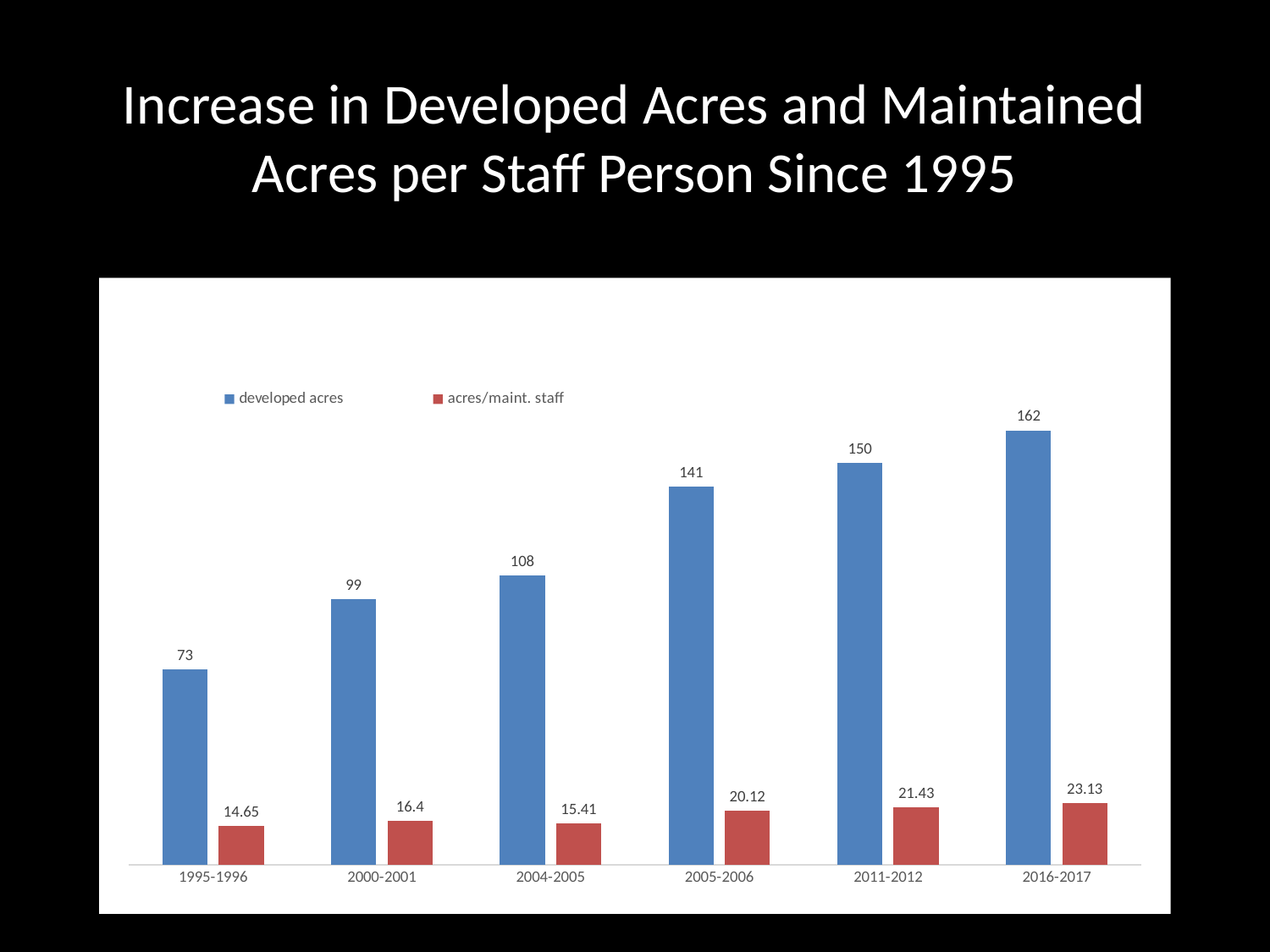
Do the developed acres values rise or fall from 1995-1996 to 2016-2017? rise What is the difference in developed acres between 2016-2017 and 1995-1996? 89 How many series does the legend list? 2 Which is larger, acres/maint. staff for 2000-2001 or for 2004-2005? 2000-2001 What is the difference in acres/maint. staff between 2016-2017 and 2011-2012? 1.7 What is the value of developed acres for 2004-2005? 108 What is the value of acres/maint. staff for 2011-2012? 21.43 Which colour represents the acres/maint. staff series? red Which period has the highest value for developed acres? 2016-2017 Which period has the lowest value for acres/maint. staff? 1995-1996 What kind of chart is shown on the slide? bar chart How many periods are shown on the x axis? 6